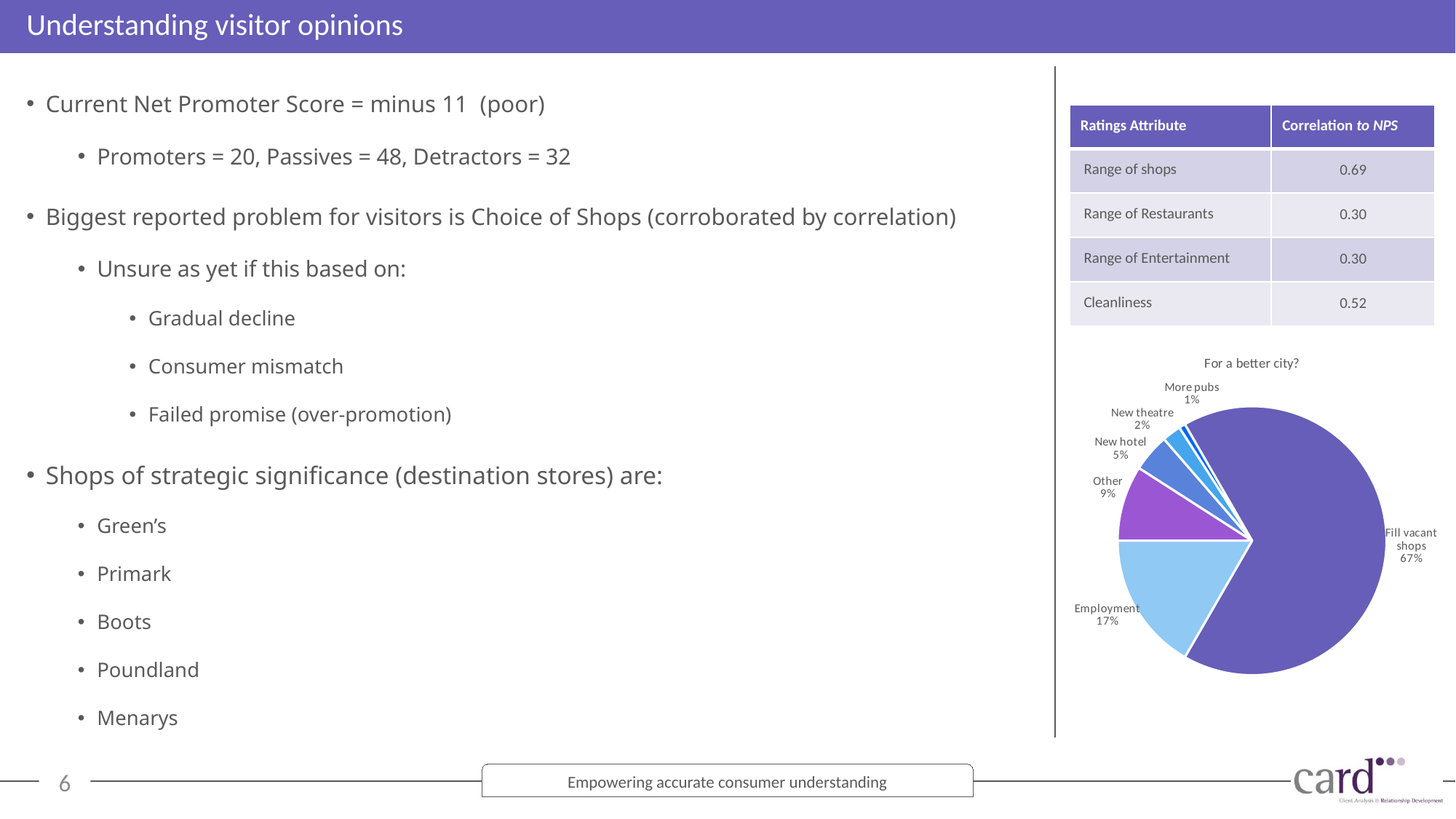
How many slices does the pie chart have? 6 What is the title of the pie chart? For a better city? What is the value for "Employment" in the pie chart? 17% What kind of chart is "For a better city?"? pie chart What is the difference between the "Fill vacant shops" and "Employment" shares in the pie chart? 50% In the pie chart, which is larger: "New theatre" or "New hotel"? New hotel What is the value for "New hotel" in the pie chart? 5% Which category has the largest slice in the pie chart? Fill vacant shops What is the value for "Other" in the pie chart? 9% What is the value for "New theatre" in the pie chart? 2% What share of the pie does "Fill vacant shops" have? 67% Which category has the smallest slice in the pie chart? More pubs